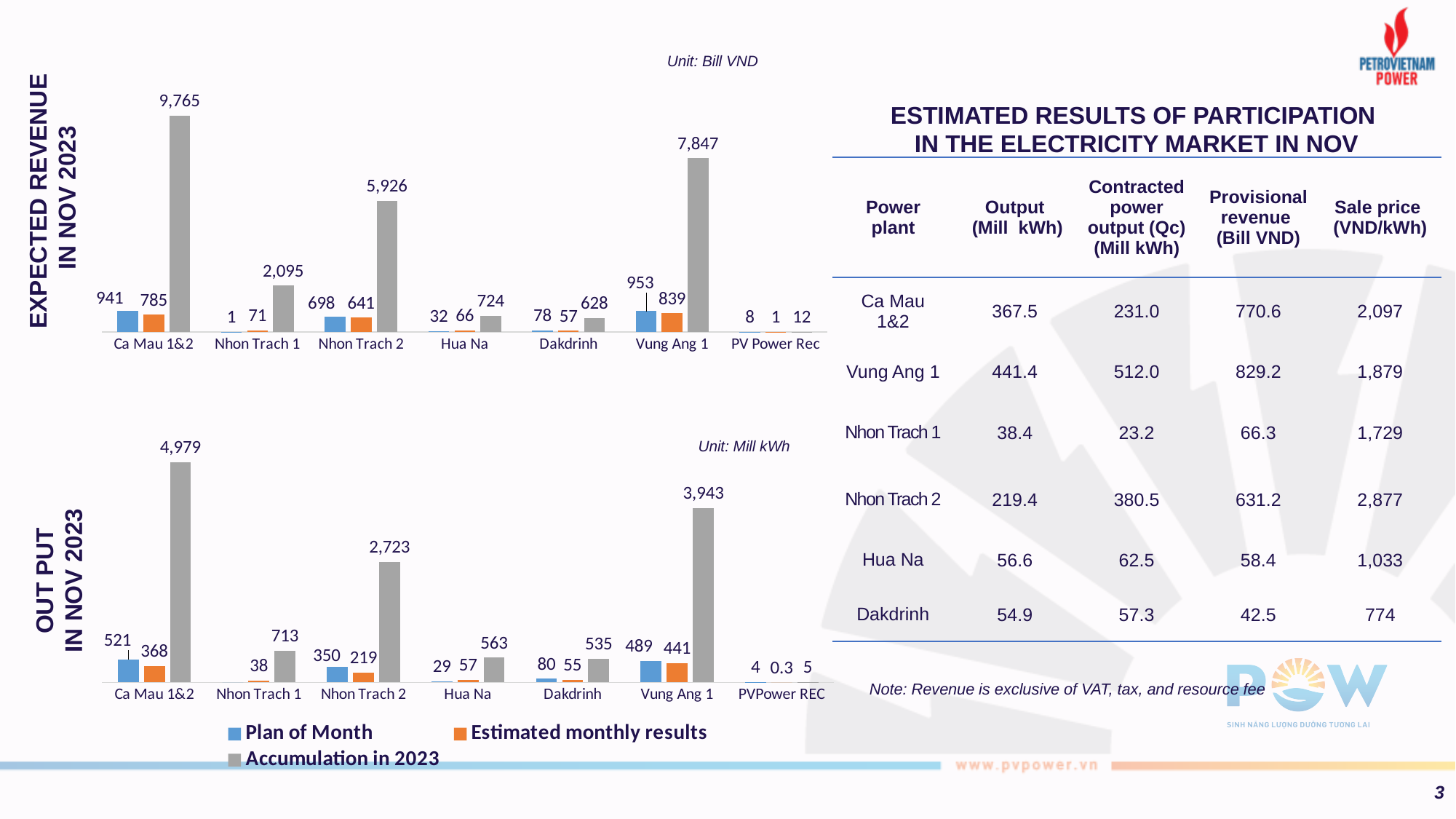
How many series does the legend list for the charts on the slide? 3 In the Expected Revenue in Nov 2023 chart, which category has the highest Accumulation in 2023 value? Ca Mau 1&2 In the Output in Nov 2023 chart, which category has the lowest Accumulation in 2023 value? PVPower REC In the Expected Revenue in Nov 2023 chart, which is larger for Hua Na: Plan of Month or Estimated monthly results? Estimated monthly results In the Expected Revenue in Nov 2023 chart, what is the Accumulation in 2023 value for Ca Mau 1&2? 9,765 In the Output in Nov 2023 chart, what is the Estimated monthly results value for Ca Mau 1&2? 368 How many categories are shown on the x axis of the Output in Nov 2023 chart? 7 In the Expected Revenue in Nov 2023 chart, what is the Plan of Month value for Vung Ang 1? 953 What type of chart is the Expected Revenue in Nov 2023 chart? Bar chart In the Output in Nov 2023 chart, what is the Accumulation in 2023 value for Vung Ang 1? 3,943 In the Expected Revenue in Nov 2023 chart, what is the difference between the Plan of Month and Estimated monthly results values for Nhon Trach 2? 57 In the Output in Nov 2023 chart, what is the difference between the Accumulation in 2023 values for Ca Mau 1&2 and Nhon Trach 2? 2,256